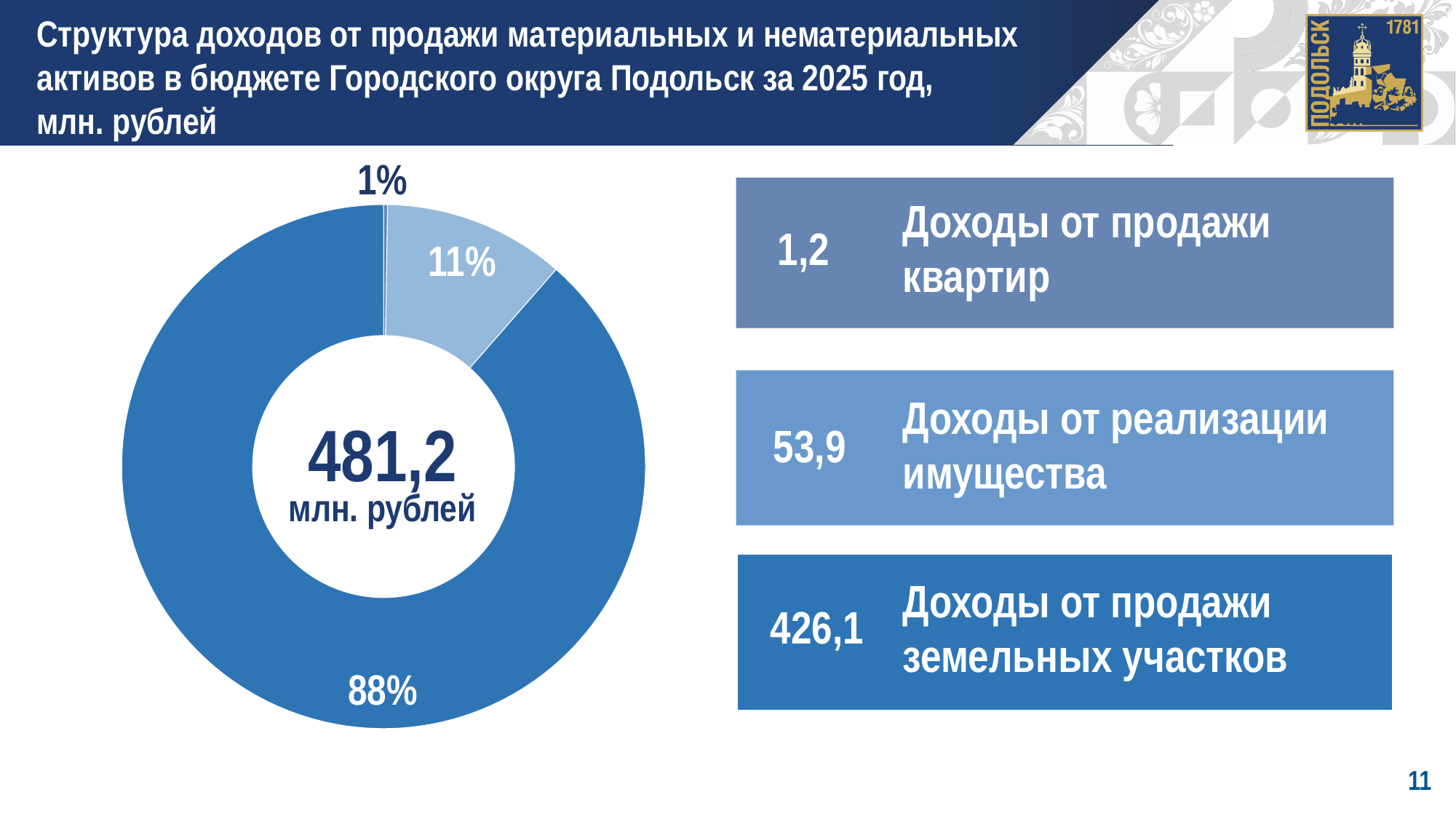
What is the difference between the values for 'Доходы от реализации имущества' and 'Доходы от продажи квартир'? 52,7 What share of the chart is 'Доходы от реализации имущества'? 11% What is the value for 'Доходы от реализации имущества'? 53,9 What kind of chart is shown on the slide? Pie chart (donut) Which category has the smallest share of the chart? Доходы от продажи квартир Which category has the largest share of the chart? Доходы от продажи земельных участков What share of the chart is 'Доходы от продажи земельных участков'? 88% What is the value for 'Доходы от продажи земельных участков'? 426,1 How many categories does the chart show? 3 What is the total shown in the centre of the chart? 481,2 млн. рублей What share of the chart is 'Доходы от продажи квартир'? 1% What is the value for 'Доходы от продажи квартир'? 1,2